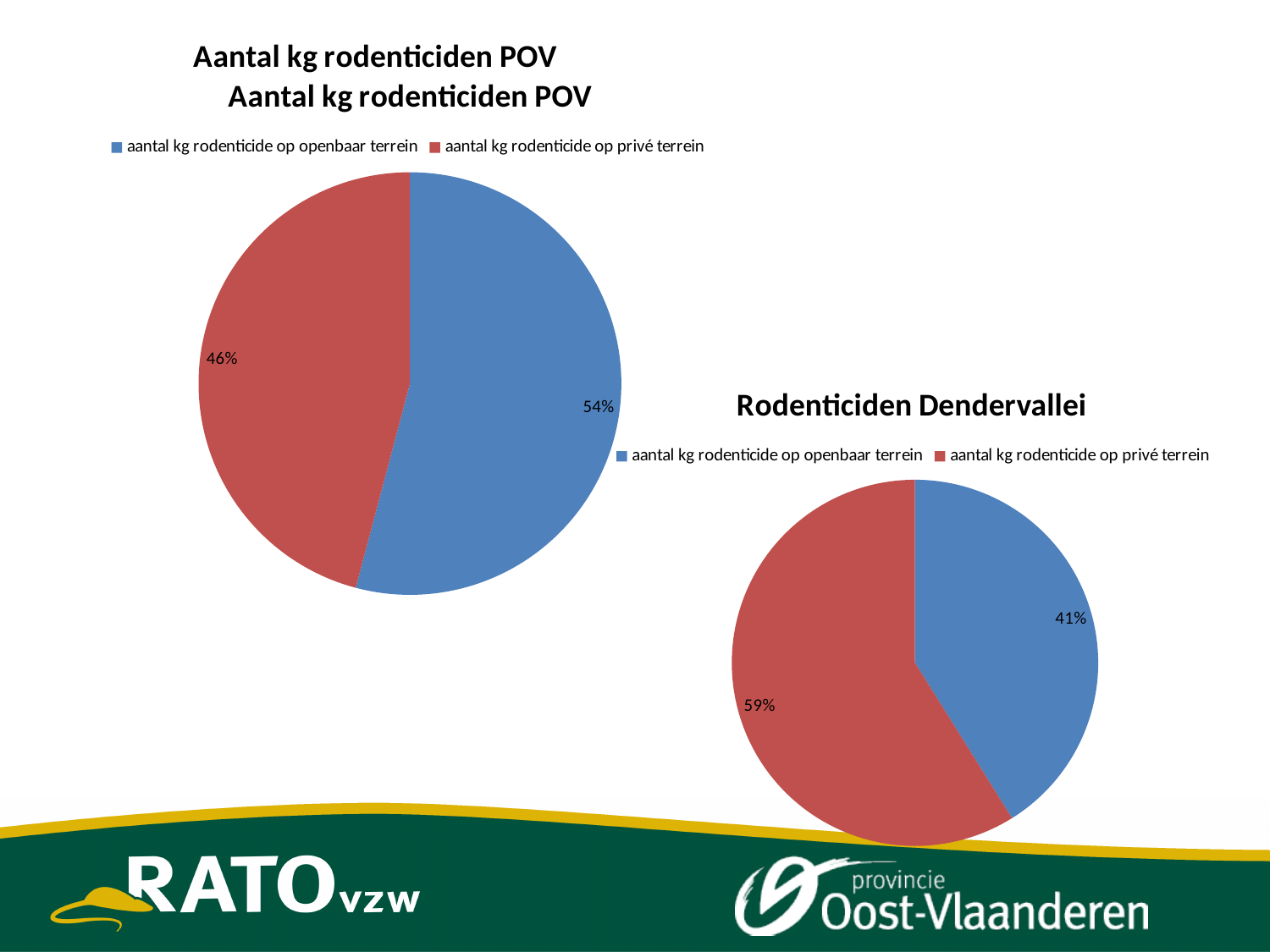
In the 'Aantal kg rodenticiden POV' chart, which category has the largest slice? aantal kg rodenticide op openbaar terrein Which chart has the larger share for 'aantal kg rodenticide op privé terrein', 'Aantal kg rodenticiden POV' or 'Rodenticiden Dendervallei'? Rodenticiden Dendervallei In the 'Rodenticiden Dendervallei' chart, what share is 'aantal kg rodenticide op openbaar terrein'? 41% In the 'Aantal kg rodenticiden POV' chart, what share is 'aantal kg rodenticide op privé terrein'? 46% In the 'Rodenticiden Dendervallei' chart, what is the difference in percentage points between the privé terrein slice and the openbaar terrein slice? 18 In the 'Rodenticiden Dendervallei' chart, which category has the smallest slice? aantal kg rodenticide op openbaar terrein How many categories does the 'Aantal kg rodenticiden POV' chart show? 2 What kind of chart is 'Rodenticiden Dendervallei'? pie chart In the 'Rodenticiden Dendervallei' chart, what share is 'aantal kg rodenticide op privé terrein'? 59% In the 'Aantal kg rodenticiden POV' chart, what is the difference in percentage points between the openbaar terrein slice and the privé terrein slice? 8 In the 'Rodenticiden Dendervallei' chart, what colour is the slice for 'aantal kg rodenticide op privé terrein'? red